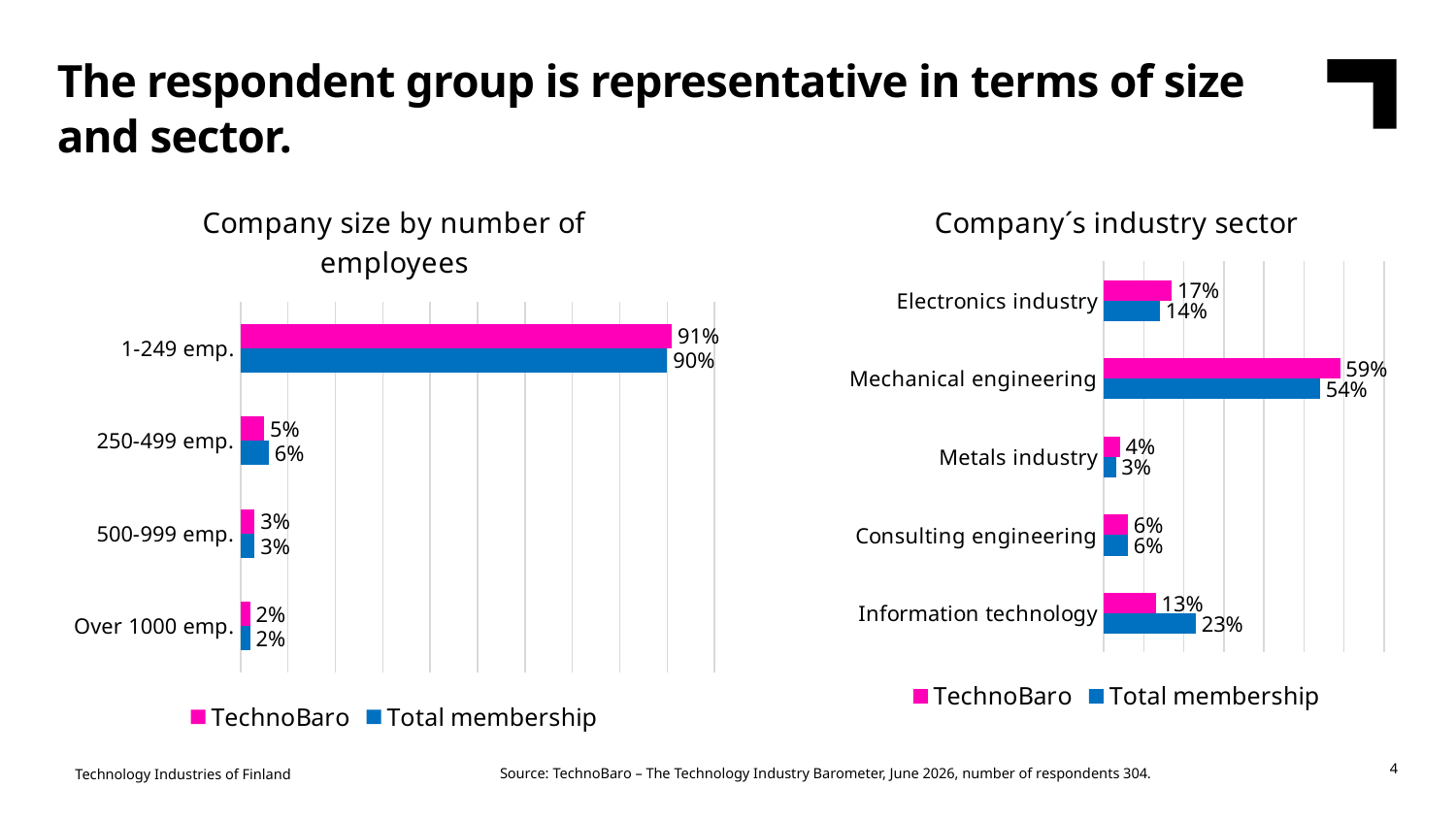
In the 'Company size by number of employees' chart, what is the Total membership value for 250-499 emp.? 6% In the 'Company size by number of employees' chart, which category has the lowest Total membership value? Over 1000 emp. In the 'Company´s industry sector' chart, which is larger for Electronics industry: the TechnoBaro value or the Total membership value? TechnoBaro In the 'Company´s industry sector' chart, what is the difference between the TechnoBaro and Total membership values for Information technology? 10% In the 'Company size by number of employees' chart, what is the TechnoBaro value for 1-249 emp.? 91% What type of chart is the 'Company size by number of employees' chart? Bar chart In the 'Company´s industry sector' chart, which sector has the lowest Total membership value? Metals industry In the 'Company´s industry sector' chart, what is the TechnoBaro value for Mechanical engineering? 59% In the 'Company size by number of employees' chart, which category has the highest TechnoBaro value? 1-249 emp. In the 'Company size by number of employees' chart, how many company size categories are shown? 4 How many series does the legend of the 'Company´s industry sector' chart list? 2 In the 'Company´s industry sector' chart, what is the Total membership value for Information technology? 23%